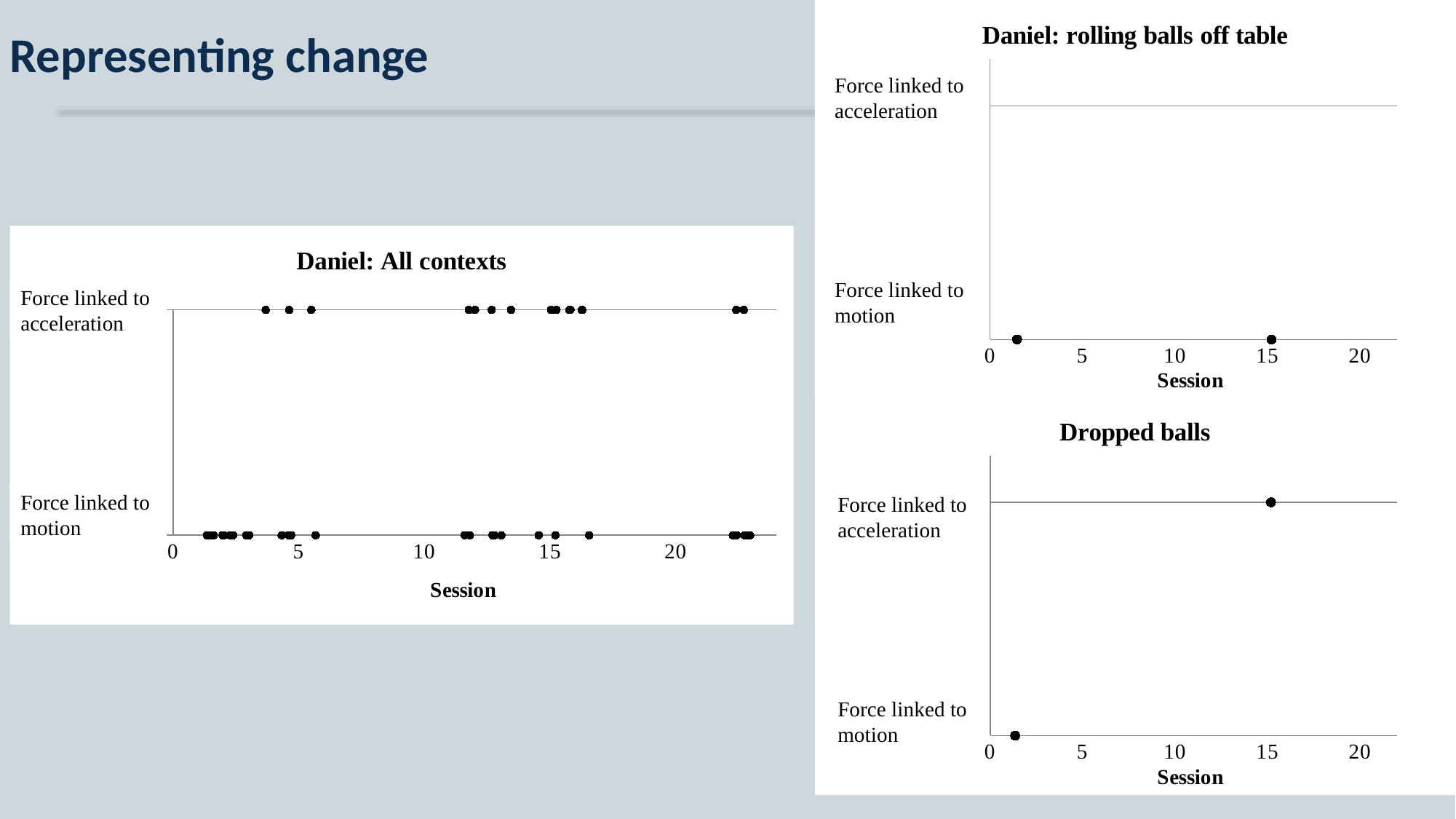
In the "Daniel: All contexts" chart, which level has more plotted points: "Force linked to acceleration" or "Force linked to motion"? Force linked to motion In the "Daniel: rolling balls off table" chart, at which level are both plotted points: "Force linked to acceleration" or "Force linked to motion"? Force linked to motion In the "Dropped balls" chart, is the session value of the point at "Force linked to acceleration" greater or less than 10? greater In the "Daniel: rolling balls off table" chart, is the later of the two points at a session greater or less than 10? greater What is the x-axis label on the "Daniel: All contexts" chart? Session In the "Dropped balls" chart, how many data points are plotted? 2 In the "Dropped balls" chart, is the session value of the point at "Force linked to motion" greater or less than 5? less What is the title of the chart in the top right of the slide? Daniel: rolling balls off table What kind of chart is "Daniel: All contexts"? scatter chart In the "Daniel: All contexts" chart, how many levels are labelled on the vertical axis? 2 How many charts are shown on the slide? 3